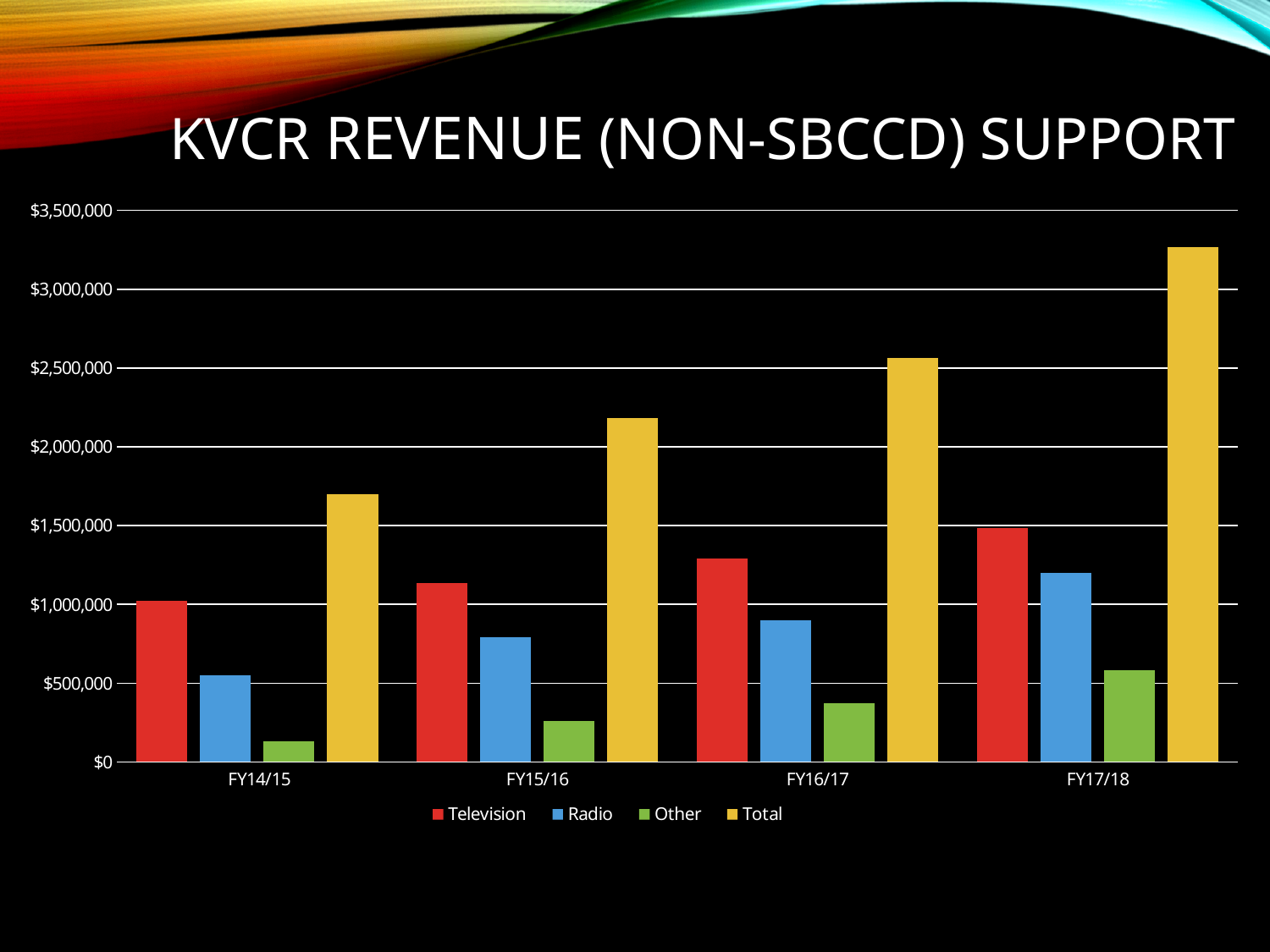
Is the Other value for FY15/16 greater or less than $500,000? less Which fiscal year has the lowest Other bar? FY14/15 Is the Radio value for FY14/15 greater or less than $1,000,000? less Do the Total values rise or fall from FY14/15 to FY17/18? rise Which is larger in FY17/18, the Television value or the Radio value? Television How many fiscal years are shown on the x axis? 4 Is the Television value for FY16/17 greater or less than $1,000,000? greater What kind of chart is shown on the slide? bar chart What is the title of the chart? KVCR REVENUE (NON-SBCCD) SUPPORT How many series does the legend list? 4 Which fiscal year has the highest Total bar? FY17/18